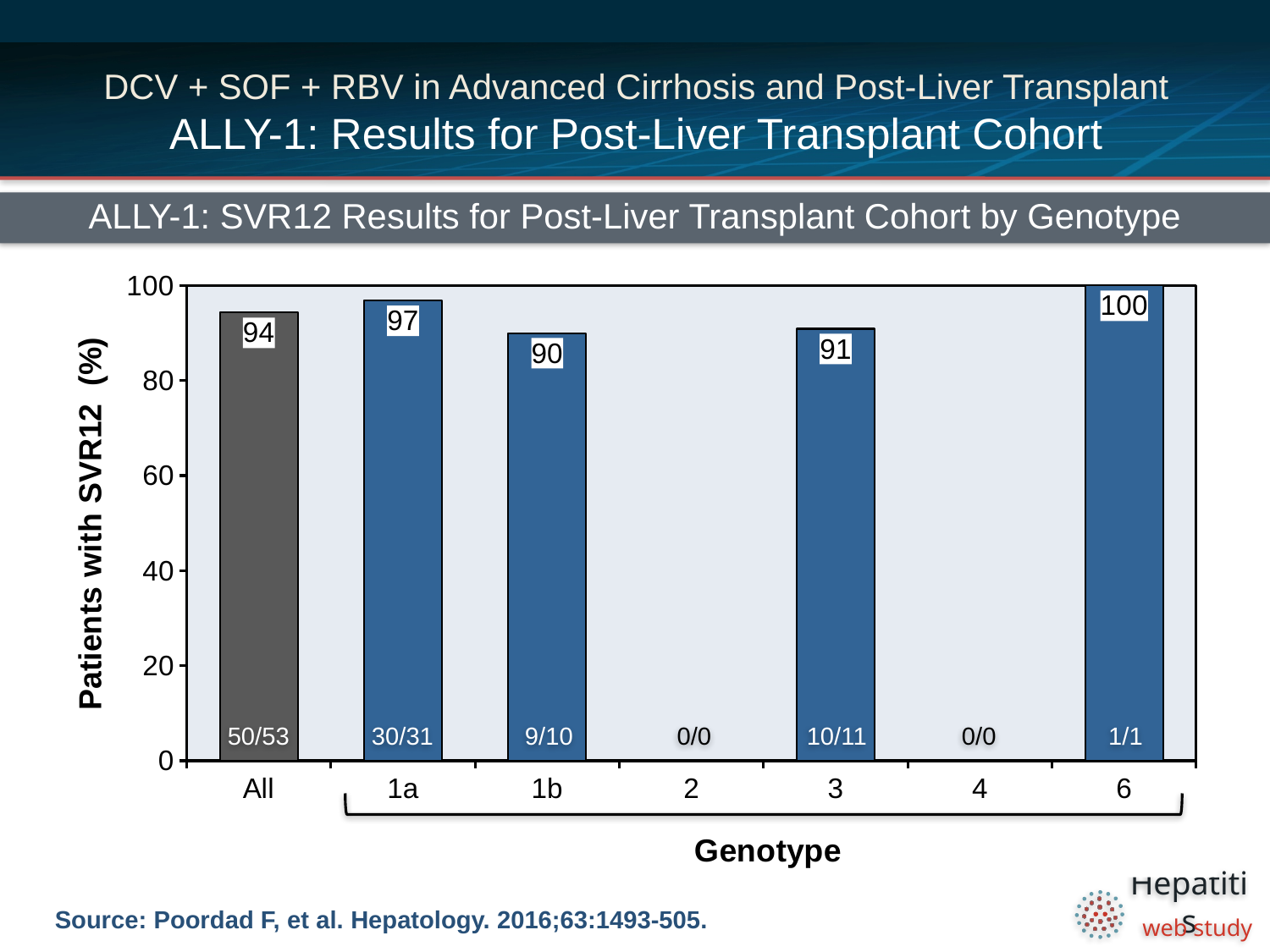
Which has a higher SVR12 rate, genotype 1a or genotype 3? 1a What is the SVR12 rate for genotype 3? 91 How many genotype categories are labelled on the x axis, including All? 7 What is the SVR12 rate for genotype 1b? 90 What is the SVR12 rate for genotype 6? 100 What is the difference in SVR12 rate between genotype 1a and genotype 1b? 7 Which genotype has the highest SVR12 rate? 6 What is the SVR12 rate for genotype 1a? 97 What is the patient fraction shown for genotype 1a? 30/31 What kind of chart is shown on the slide? Bar chart What is the SVR12 rate for the All group? 94 How many patients achieved SVR12 in the All group, as shown at the base of the bar? 50/53